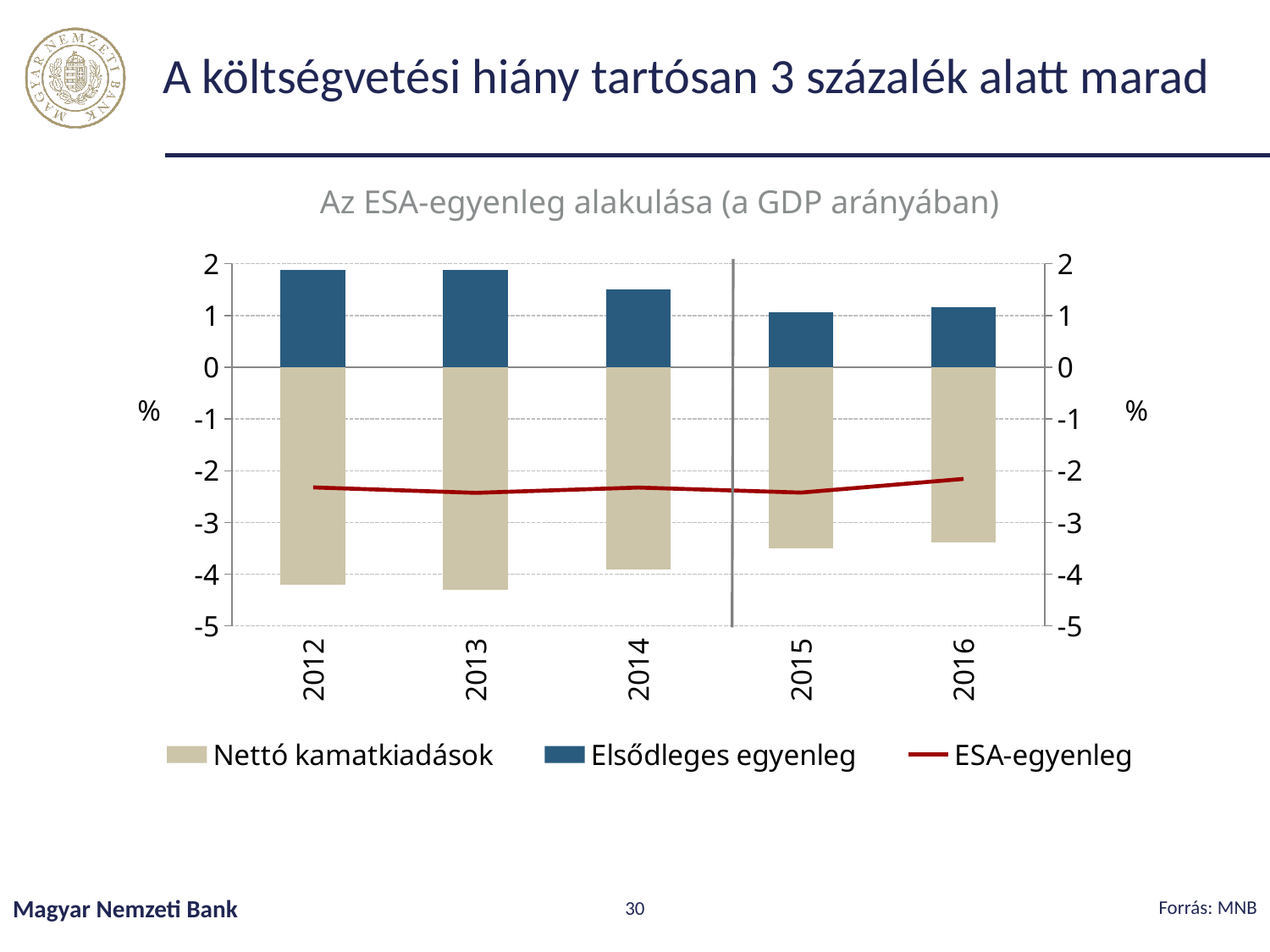
Does the Elsődleges egyenleg series rise or fall from 2012 to 2015? fall Is the value of Nettó kamatkiadások for 2012 greater or less than -4? less How many years are shown on the x axis of the chart? 5 How many series does the chart's legend list? 3 Is the value of Elsődleges egyenleg for 2014 greater or less than 1? greater Is the value of ESA-egyenleg for 2013 greater or less than -2? less What is the title of the chart? Az ESA-egyenleg alakulása (a GDP arányában) Which series is drawn as a red line in the chart? ESA-egyenleg What kind of chart is shown on the slide? A bar chart with a line series Which is larger, the Elsődleges egyenleg value for 2012 or for 2015? 2012